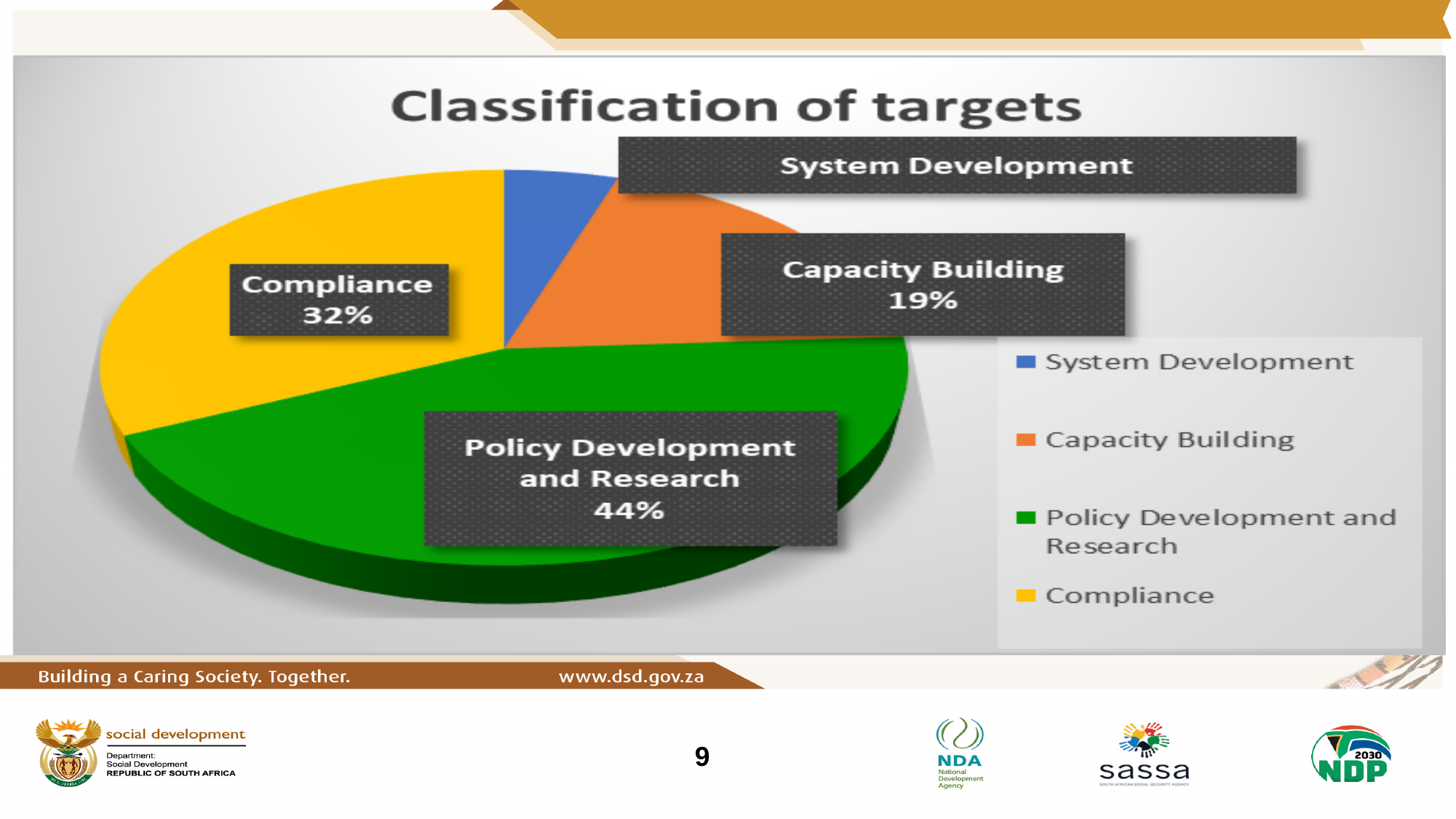
What is the title of the chart? Classification of targets What percentage of targets is classified as Compliance? 32% Which classification has the largest share of targets? Policy Development and Research What colour represents Capacity Building in the chart? Orange Which classification has the smallest share of targets? System Development What is the difference in percentage points between Compliance and Capacity Building? 13 How many categories does the legend list? 4 What percentage of targets is classified as Capacity Building? 19% What is the difference in percentage points between Policy Development and Research and Compliance? 12 What kind of chart is shown on the slide? Pie chart What percentage of targets is classified as Policy Development and Research? 44% Which is larger, the share for Compliance or the share for Capacity Building? Compliance